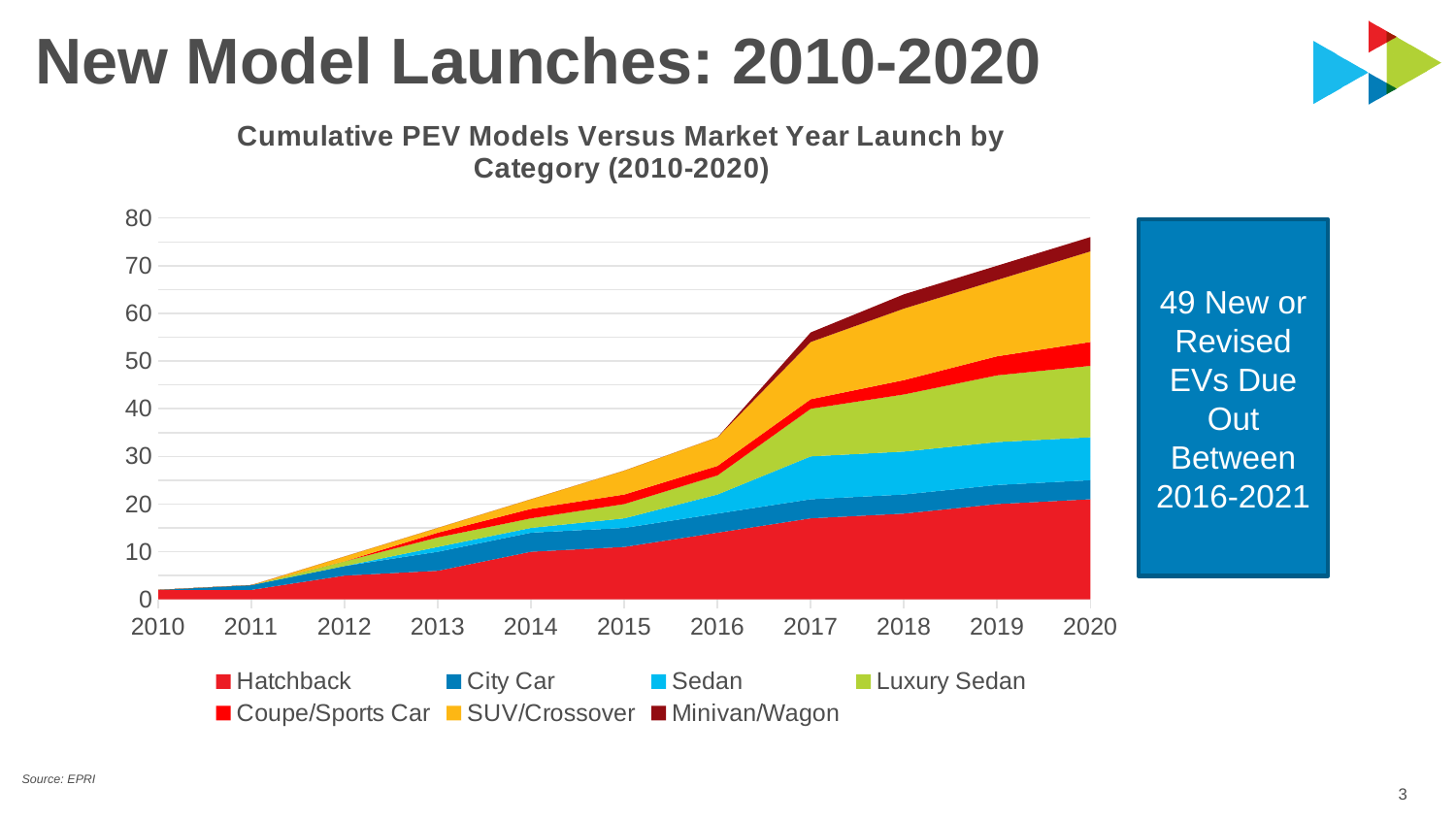
How many series does the legend list? 7 Do the cumulative PEV model totals rise or fall from 2010 to 2020? Rise Is the cumulative total of all categories in 2017 greater or less than 50? greater Which category is larger in 2020, Hatchback or Minivan/Wagon? Hatchback What is the title of the chart? Cumulative PEV Models Versus Market Year Launch by Category (2010-2020) How many years are shown along the x axis? 11 In which year is the cumulative total of PEV models lowest? 2010 Is the cumulative total of all categories in 2018 greater or less than 60? greater What kind of chart is shown on the slide? Stacked area chart In which year is the cumulative total of PEV models highest? 2020 Is the cumulative total of all categories in 2020 greater or less than 70? greater